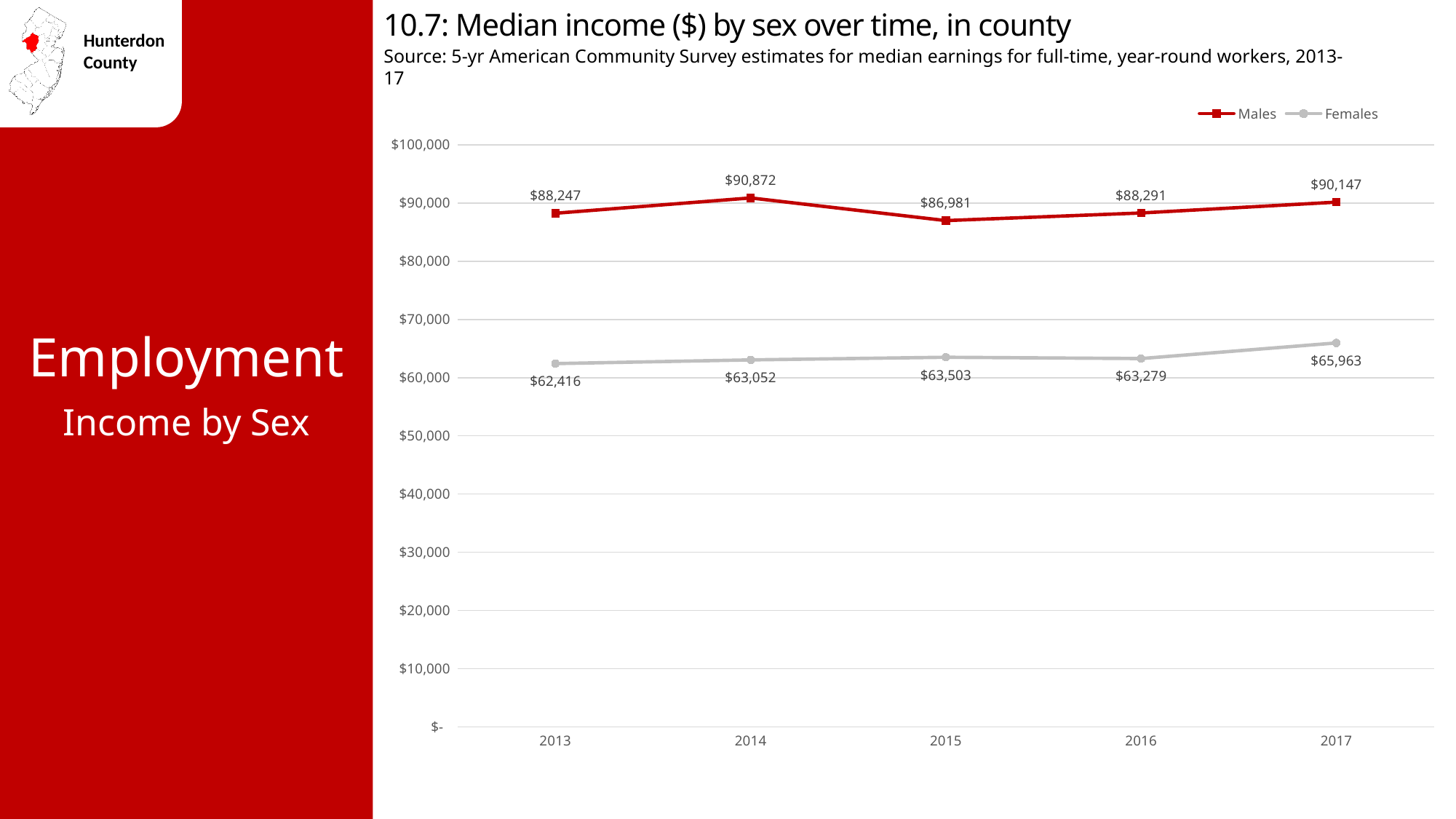
How many years are shown on the x axis? 5 What is the difference between the Males and Females median income in 2013? $25,831 Which was higher for Males: the median income in 2016 or in 2017? 2017 What was the median income for Males in 2015? $86,981 Which colour is used for the Males series? red What kind of chart is shown on the slide? line chart What was the median income for Females in 2017? $65,963 In which year was the median income for Females lowest? 2013 What was the median income for Males in 2014? $90,872 Is the median income for Females in 2015 greater or less than $70,000? less How many series does the legend list? 2 In which year was the median income for Males highest? 2014